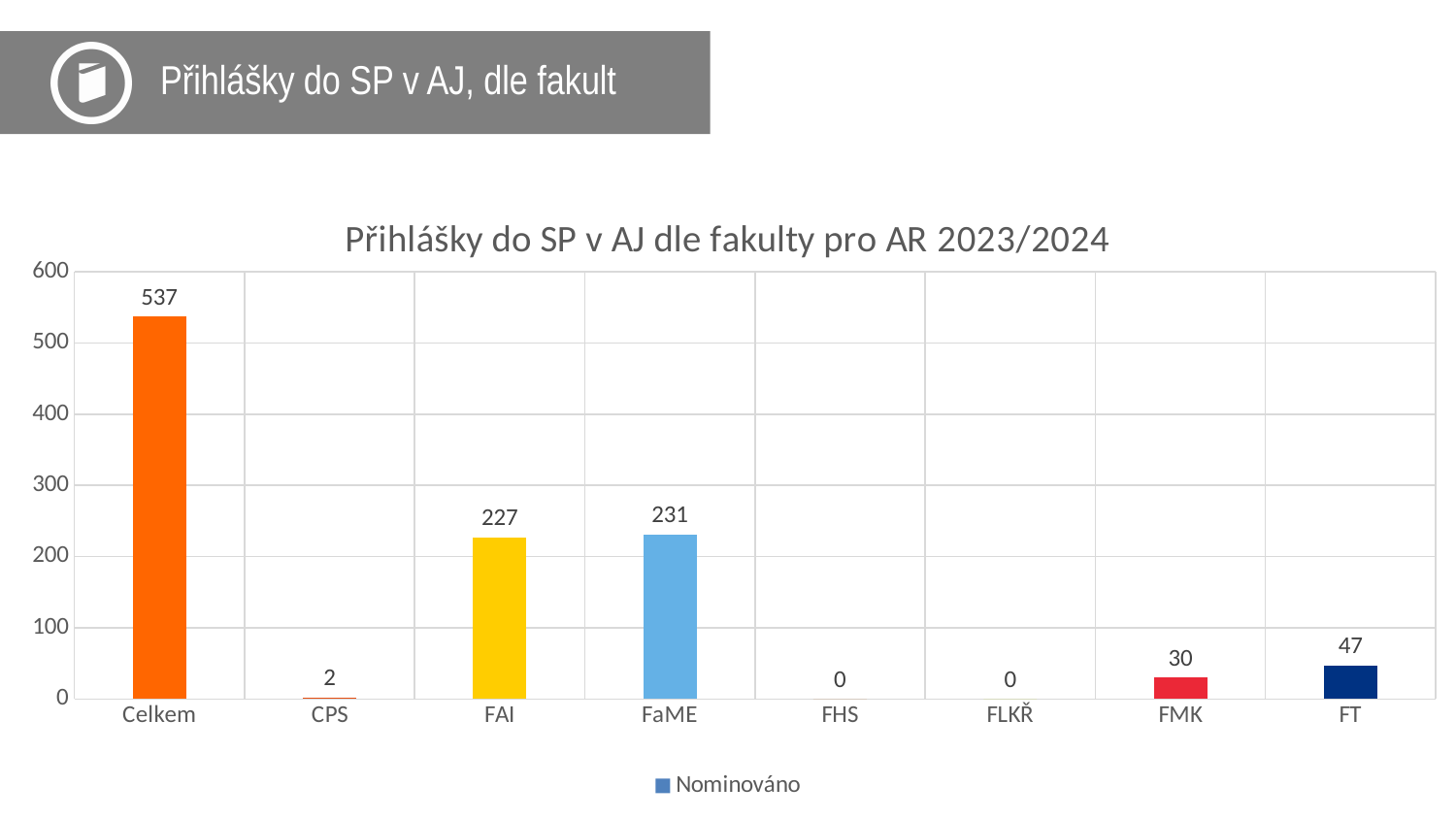
What kind of chart is shown on the slide? Bar chart What is the value for FaME? 231 How many categories are shown on the x axis? 8 What is the value for FMK? 30 What is the difference between the values for FT and FMK? 17 What is the title of the chart? Přihlášky do SP v AJ dle fakulty pro AR 2023/2024 What is the difference between the values for FaME and FAI? 4 Which is larger, the value for FT or the value for FMK? FT What is the value for Celkem? 537 What is the value for FAI? 227 Which category has the highest value? Celkem What is the value for FT? 47